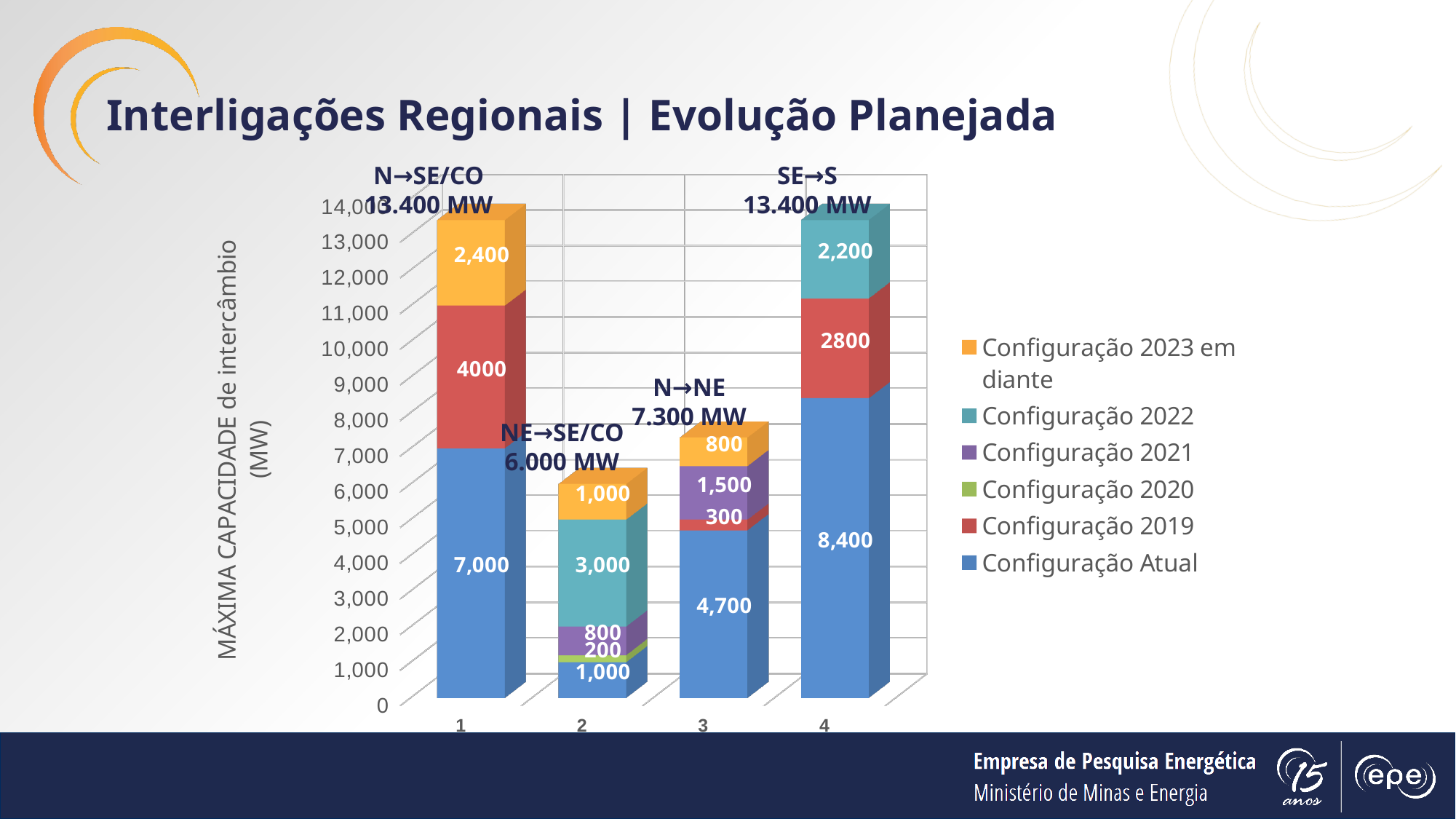
What is the difference between the Configuração Atual values of SE→S (8,400) and N→SE/CO (7,000)? 1,400 What is the value of Configuração 2019 for the SE→S interconnection (bar 4)? 2800 Which interconnection has the lowest Configuração Atual value? NE→SE/CO Which is larger: the Configuração 2023 em diante value for N→SE/CO or for NE→SE/CO? N→SE/CO What is the value of Configuração 2022 for the NE→SE/CO interconnection (bar 2)? 3,000 How many series does the legend list? 6 What type of chart is shown on the slide? Stacked bar chart Which interconnection has the highest Configuração Atual value? SE→S What is the value of Configuração 2021 for the N→NE interconnection (bar 3)? 1,500 What is the value of Configuração Atual for the N→SE/CO interconnection (bar 1)? 7,000 How many interconnection bars are plotted in the chart? 4 What is the total maximum exchange capacity shown for the N→NE interconnection? 7.300 MW